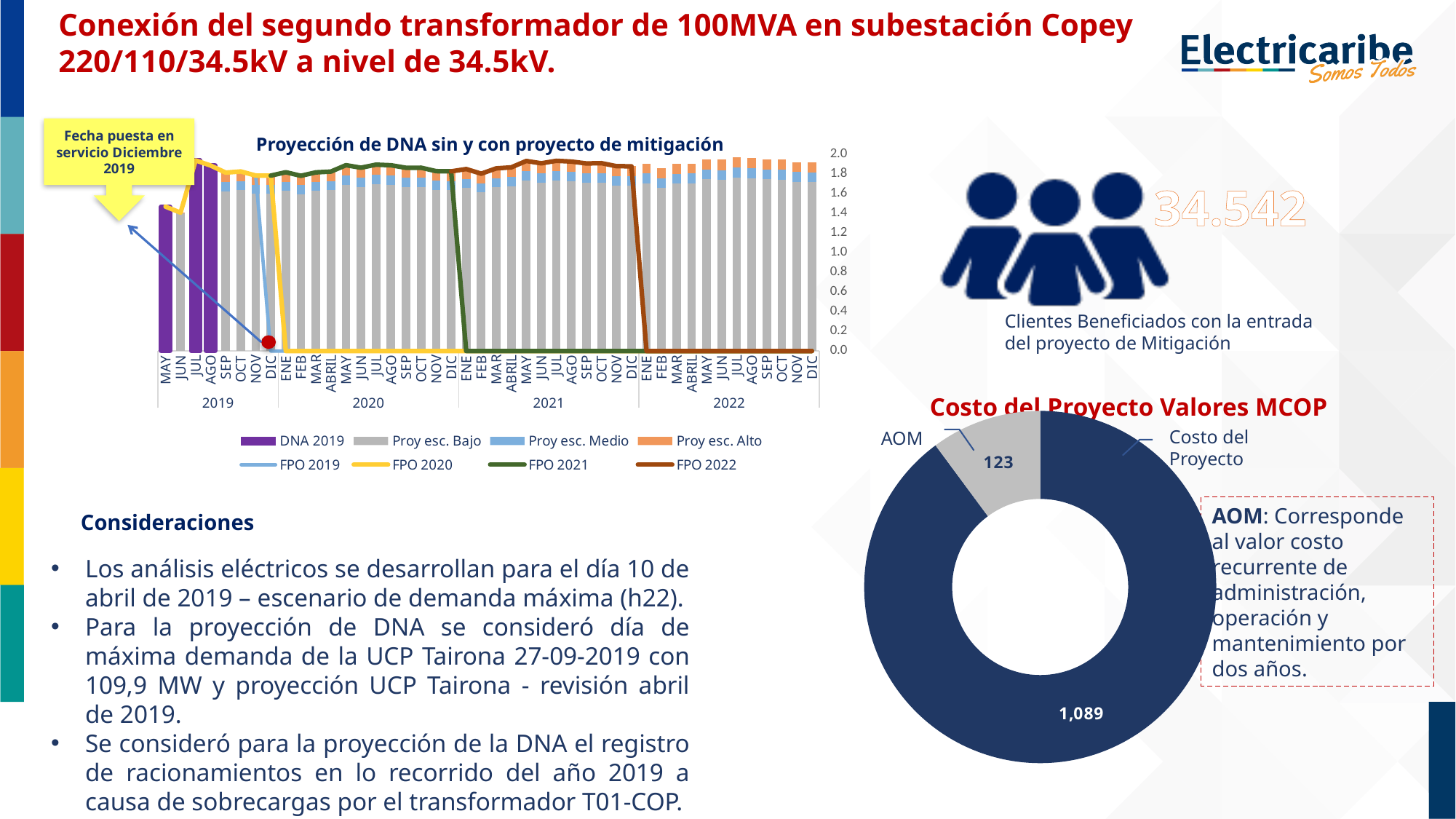
In the donut chart 'Costo del Proyecto Valores MCOP', how many slices are there? 2 In the donut chart 'Costo del Proyecto Valores MCOP', what is the value for Costo del Proyecto? 1,089 In the chart 'Proyección de DNA sin y con proyecto de mitigación', how many series does the legend list? 8 In the donut chart 'Costo del Proyecto Valores MCOP', what is the total of the two slices? 1,212 In the chart 'Proyección de DNA sin y con proyecto de mitigación', is the DNA 2019 value for JUL greater or less than 1.6? greater In the chart 'Proyección de DNA sin y con proyecto de mitigación', is the DNA 2019 value for MAY greater or less than 1.0? greater In the donut chart 'Costo del Proyecto Valores MCOP', what is the value for AOM? 123 What kind of chart is 'Costo del Proyecto Valores MCOP'? Donut (pie) chart In the donut chart 'Costo del Proyecto Valores MCOP', which slice is the largest? Costo del Proyecto In the donut chart 'Costo del Proyecto Valores MCOP', what is the difference between Costo del Proyecto and AOM? 966 In the chart 'Proyección de DNA sin y con proyecto de mitigación', what is the highest value shown on the vertical axis? 2.0 In the chart 'Proyección de DNA sin y con proyecto de mitigación', which years are shown on the x axis? 2019, 2020, 2021, 2022